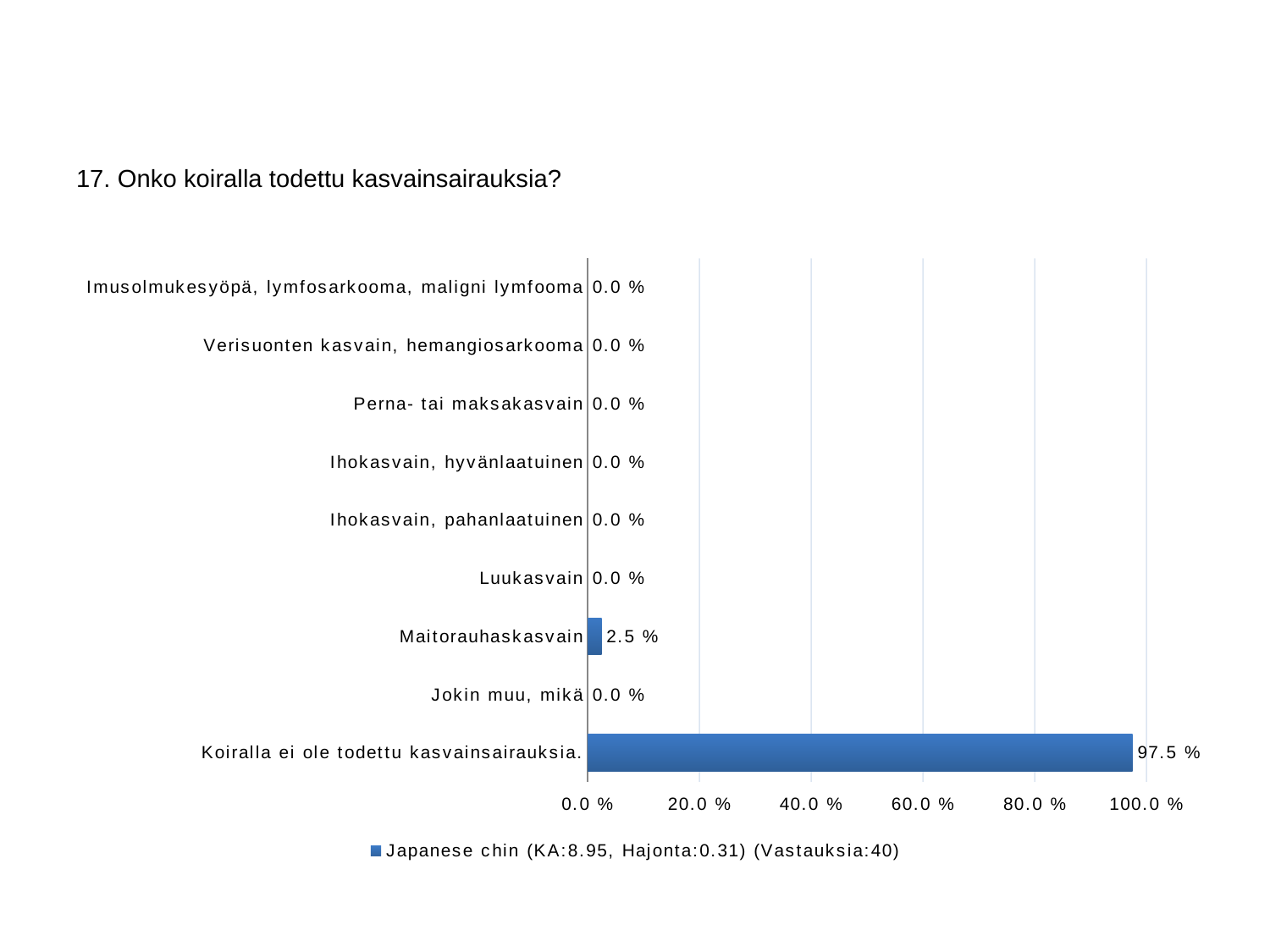
Which category has the highest value? Koiralla ei ole todettu kasvainsairauksia. What is the value for "Luukasvain"? 0.0 % What is the title of the chart? 17. Onko koiralla todettu kasvainsairauksia? Which is larger, the value for "Maitorauhaskasvain" or the value for "Jokin muu, mikä"? Maitorauhaskasvain What is the legend entry for the series? Japanese chin (KA:8.95, Hajonta:0.31) (Vastauksia:40) What is the value for "Maitorauhaskasvain"? 2.5 % What is the difference between the values for "Koiralla ei ole todettu kasvainsairauksia." and "Maitorauhaskasvain"? 95.0 % How many categories are shown on the chart? 9 Is the value for "Koiralla ei ole todettu kasvainsairauksia." greater or less than 80.0 %? greater What is the value for "Koiralla ei ole todettu kasvainsairauksia."? 97.5 % What kind of chart is shown on the slide? bar chart How many series does the legend list? 1